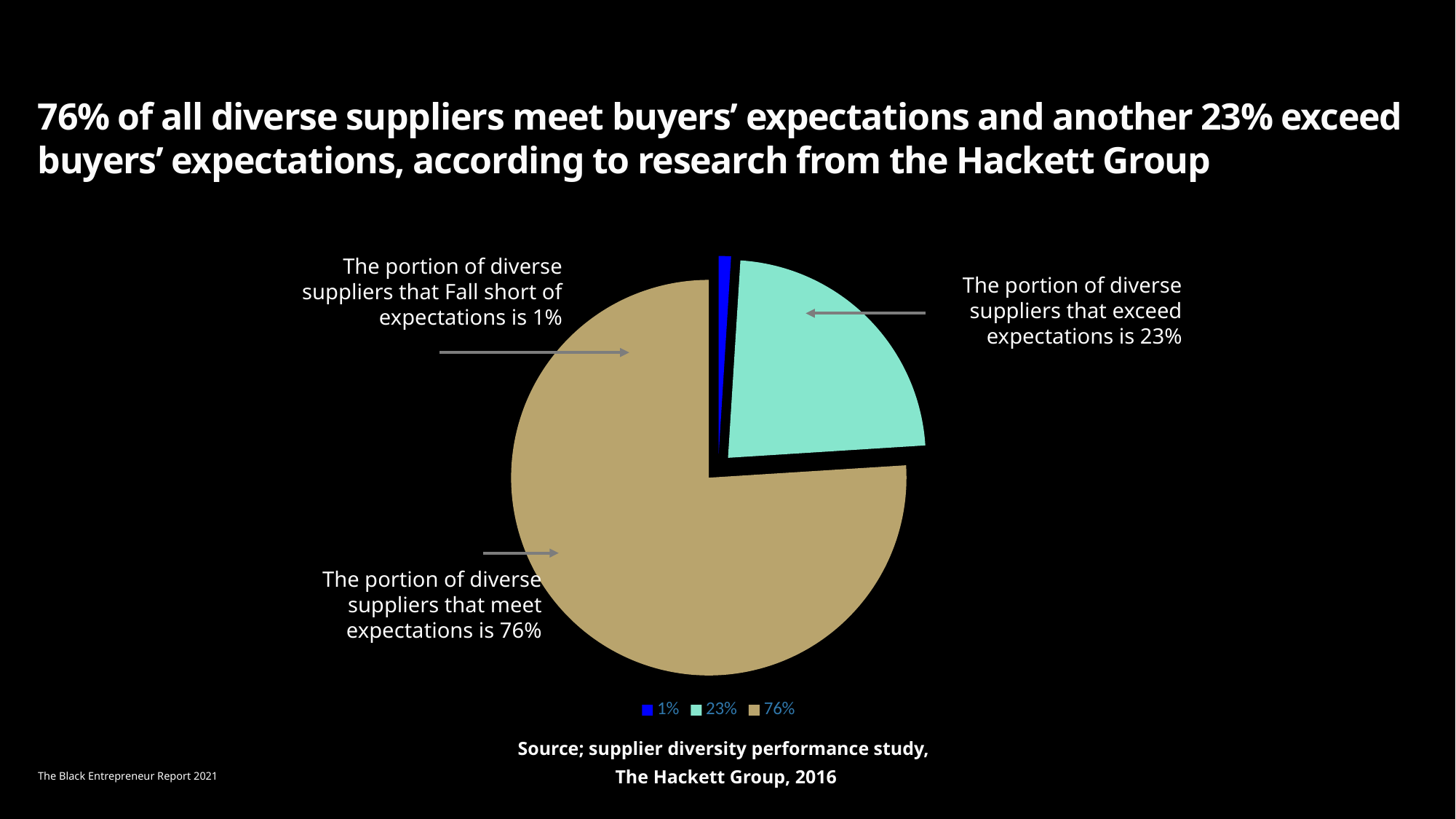
What portion of diverse suppliers meet expectations? 76% What is the difference between the share of suppliers that meet expectations and the share that exceed expectations? 53% What is the combined share of suppliers that meet or exceed expectations? 99% What colour is the slice representing suppliers that exceed expectations? light teal How many entries does the legend list? 3 Which category has the smallest slice of the pie? suppliers that fall short of expectations Which category has the largest slice of the pie? suppliers that meet expectations What portion of diverse suppliers exceed expectations? 23% What kind of chart is shown on the slide? pie chart What portion of diverse suppliers fall short of expectations? 1% Which is larger: the share of suppliers that exceed expectations or the share that fall short of expectations? exceed expectations How many slices does the pie chart have? 3